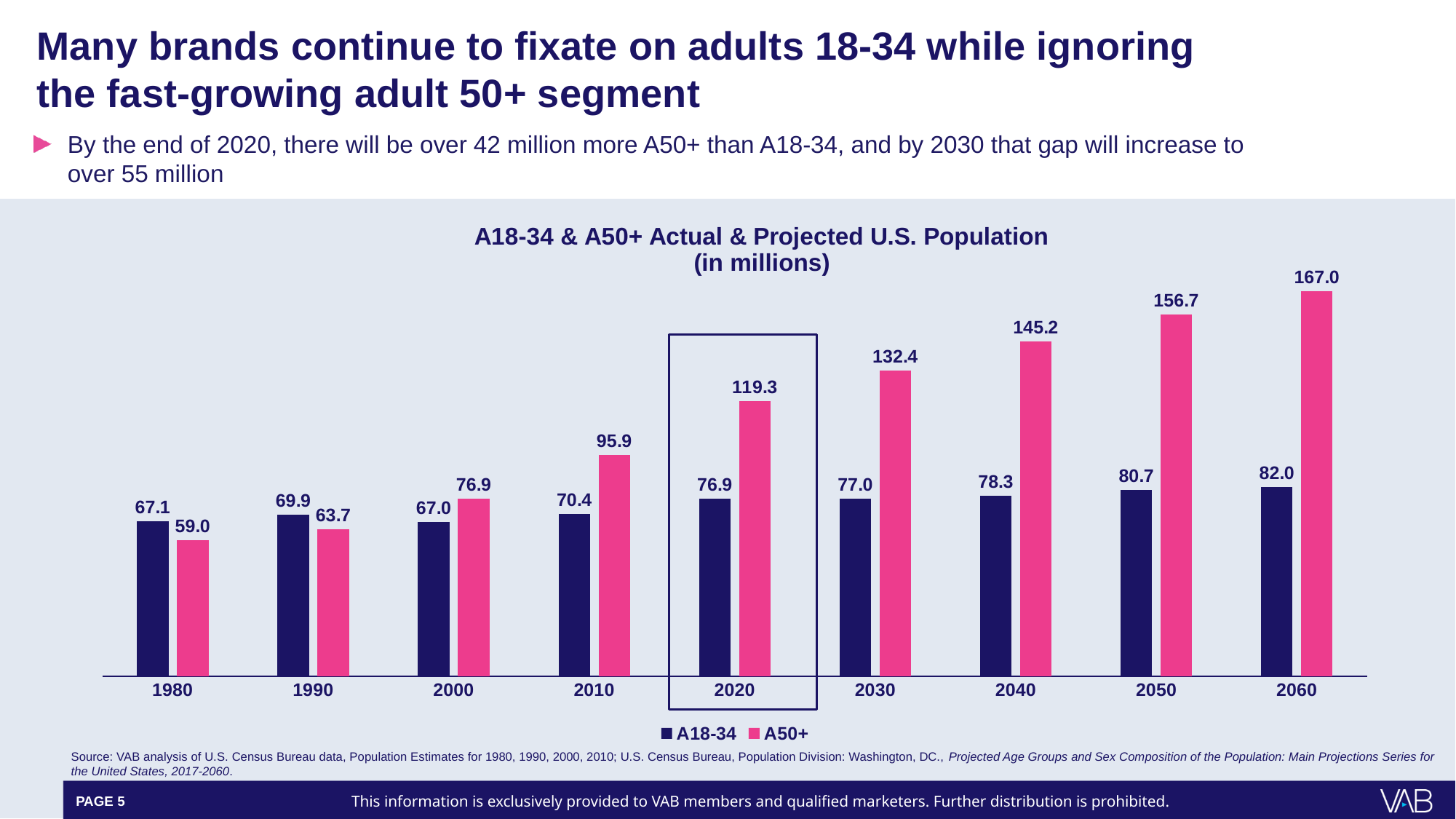
What kind of chart is shown on the slide? Bar chart Which year has the lowest A18-34 value? 2000 What is the difference between the A50+ and A18-34 values in 2020? 42.4 What is the difference between the A50+ and A18-34 values in 2030? 55.4 What is the A50+ value for 2060? 167.0 In 1990, which series has the larger value, A18-34 or A50+? A18-34 What is the A18-34 population value for 1980? 67.1 How many years are shown on the x axis? 9 What is the A50+ population value for 2020? 119.3 Which year has the lowest A50+ value? 1980 Which year has the highest A50+ value? 2060 How many series does the legend list? 2